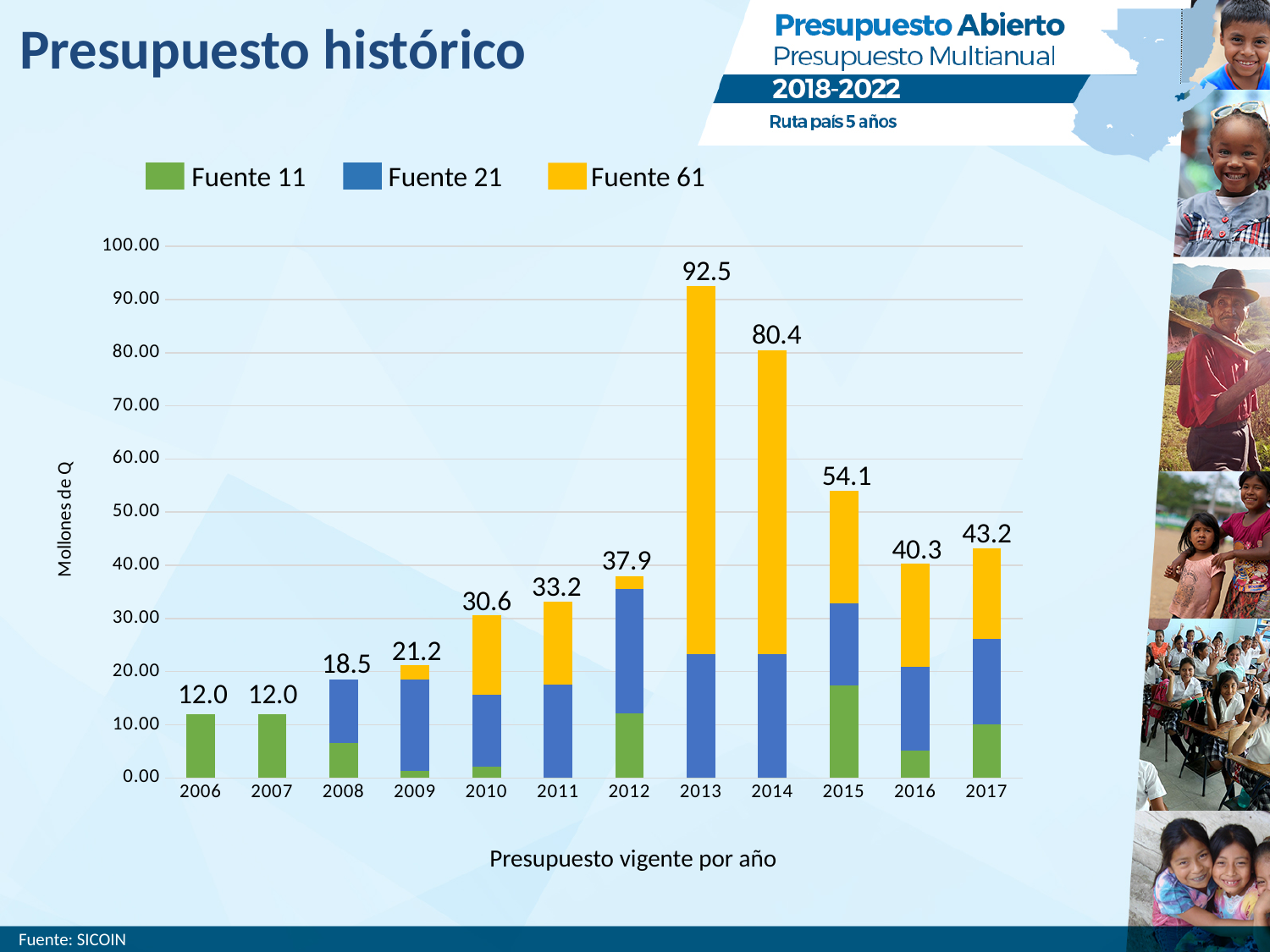
Which year has the highest total budget? 2013 What is the label on the y axis? Mollones de Q Is the Fuente 11 value for 2015 greater or less than 10.00? greater Do the total values rise or fall from 2006 to 2013? Rise How many years are shown on the x axis? 12 Which year has a larger total, 2016 or 2017? 2017 What is the total value labelled above the bar for 2010? 30.6 What is the lowest total value shown on the chart? 12.0 What is the total budget value shown for 2013? 92.5 How many series does the legend list? 3 What kind of chart is shown on the slide? Stacked bar chart What is the difference between the totals for 2013 and 2014? 12.1